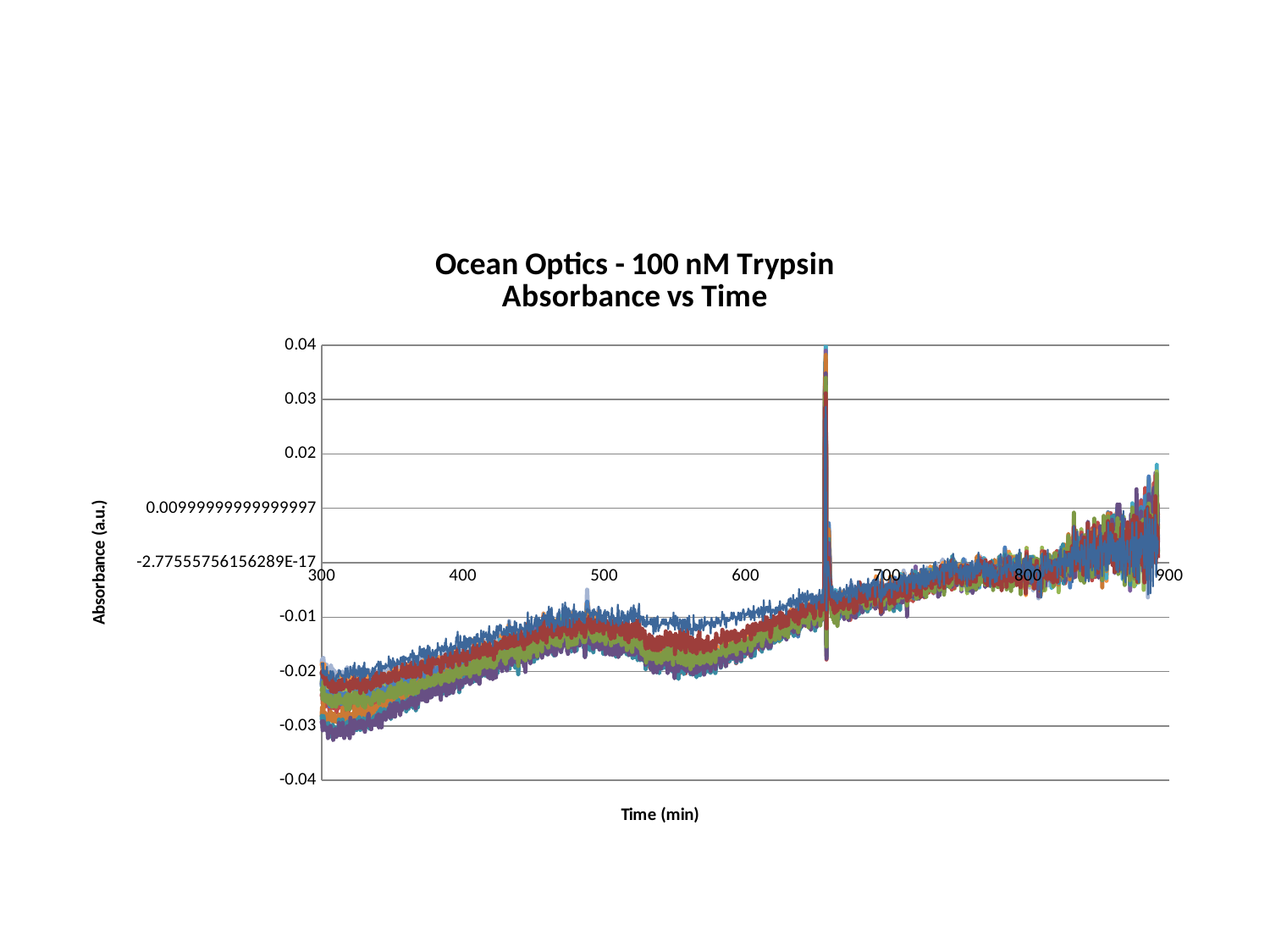
At 300 min, are the absorbance values greater or less than -0.01? less At 850 min, are the absorbance values greater or less than -0.02? greater Do the absorbance values generally rise or fall as time increases from 300 to 900 min? rise At 400 min, are the absorbance values greater or less than -0.01? less What is the label of the x axis? Time (min) What kind of chart is shown on the slide? line chart What is the title of the chart? Ocean Optics - 100 nM Trypsin Absorbance vs Time